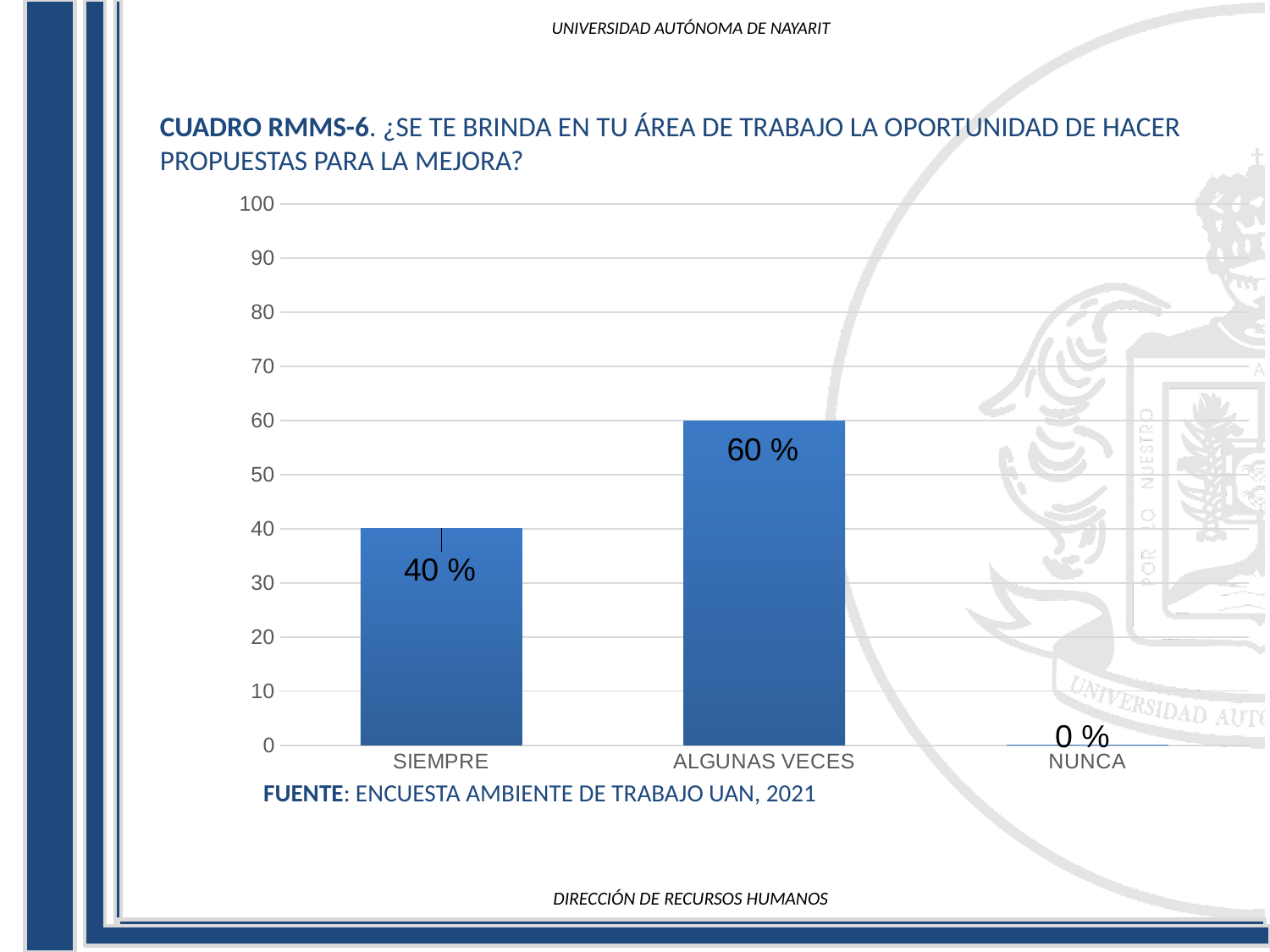
What is the value for SIEMPRE? 40 % What kind of chart is shown on the slide? bar chart What is the difference between the values for ALGUNAS VECES and SIEMPRE? 20 % Which category has the highest value? ALGUNAS VECES Which category has the lowest value? NUNCA Is the value for ALGUNAS VECES greater or less than 50? greater What is the value for NUNCA? 0 % What is the maximum value shown on the y axis? 100 What is the value for ALGUNAS VECES? 60 % What source is cited below the chart? ENCUESTA AMBIENTE DE TRABAJO UAN, 2021 Which is larger, the value for SIEMPRE or the value for ALGUNAS VECES? ALGUNAS VECES How many categories are shown on the x axis? 3